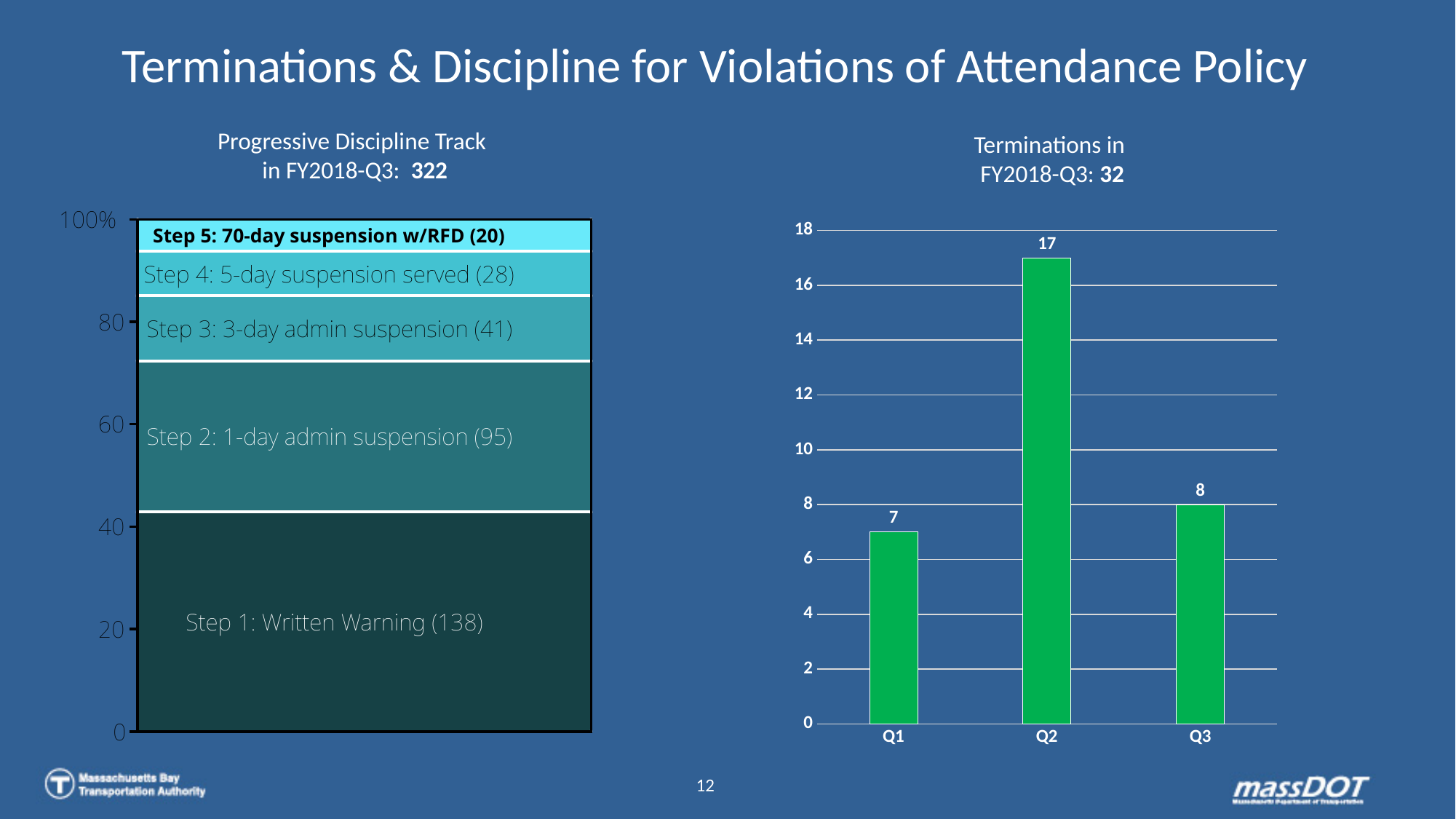
In the Terminations in FY2018-Q3 chart, how many quarters are shown on the x axis? 3 What kind of chart is the Terminations in FY2018-Q3 chart? Bar chart In the Progressive Discipline Track chart, how many cases are in Step 1: Written Warning? 138 In the Terminations in FY2018-Q3 chart, which quarter has the lowest value? Q1 In the Terminations in FY2018-Q3 chart, what is the value for Q2? 17 In the Progressive Discipline Track chart, how many steps are shown in the stacked bar? 5 In the Terminations in FY2018-Q3 chart, what is the difference between the values for Q2 and Q3? 9 In the Terminations in FY2018-Q3 chart, which quarter has the highest value? Q2 In the Terminations in FY2018-Q3 chart, which is larger, the value for Q1 or the value for Q3? Q3 In the Terminations in FY2018-Q3 chart, what is the value for Q1? 7 In the Progressive Discipline Track chart, which step has the fewest cases? Step 5: 70-day suspension w/RFD In the Progressive Discipline Track chart, how many cases are in Step 3: 3-day admin suspension? 41